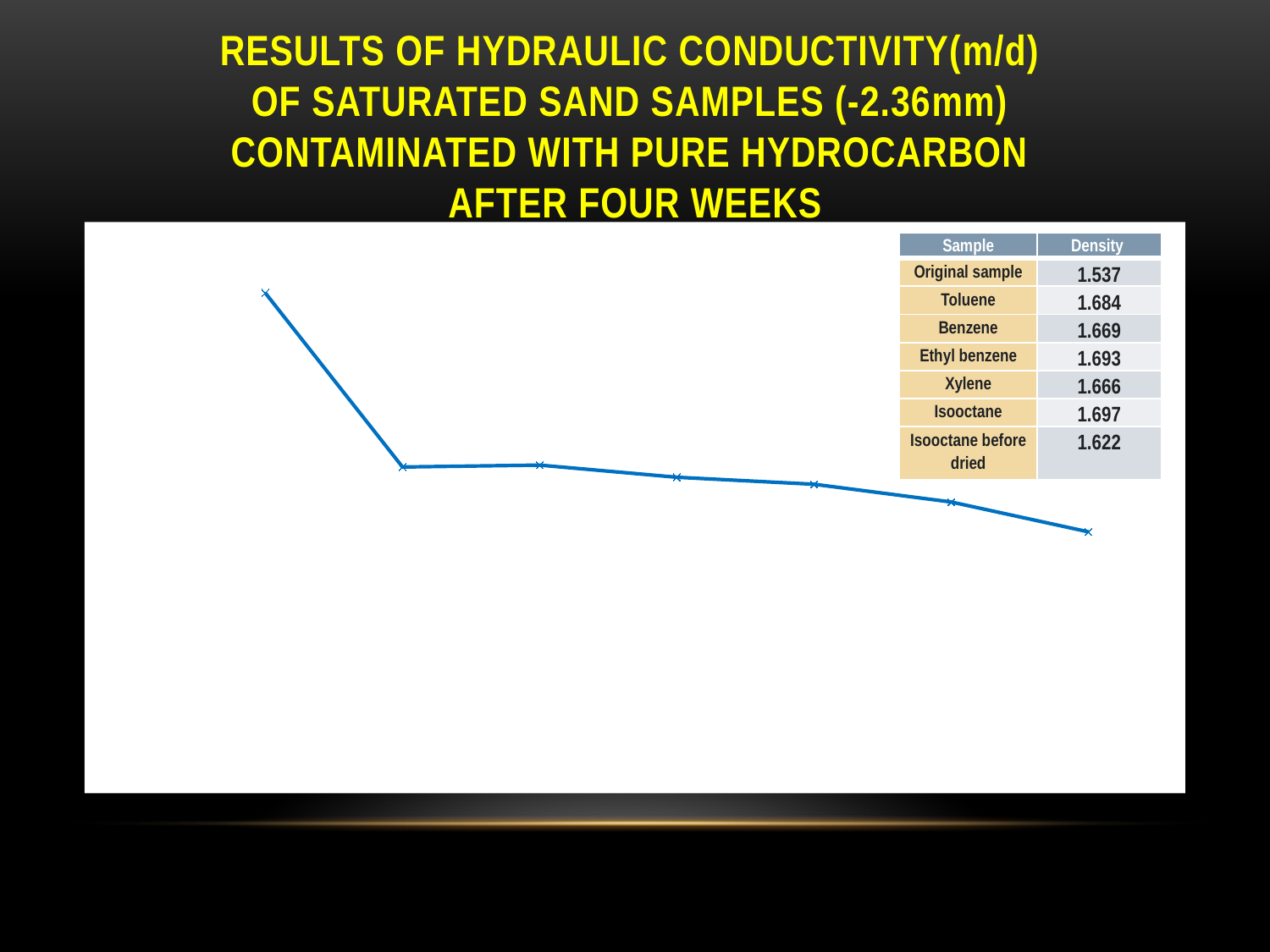
Is the first (leftmost) point on the line chart higher or lower than the last (rightmost) point? higher Do the values on the line chart generally rise or fall from left to right? fall How many data points are plotted on the line chart? 7 What colour is the line plotted on the chart? blue Which point on the line chart is the highest: the leftmost or the rightmost? leftmost What kind of chart is shown on the slide? line chart